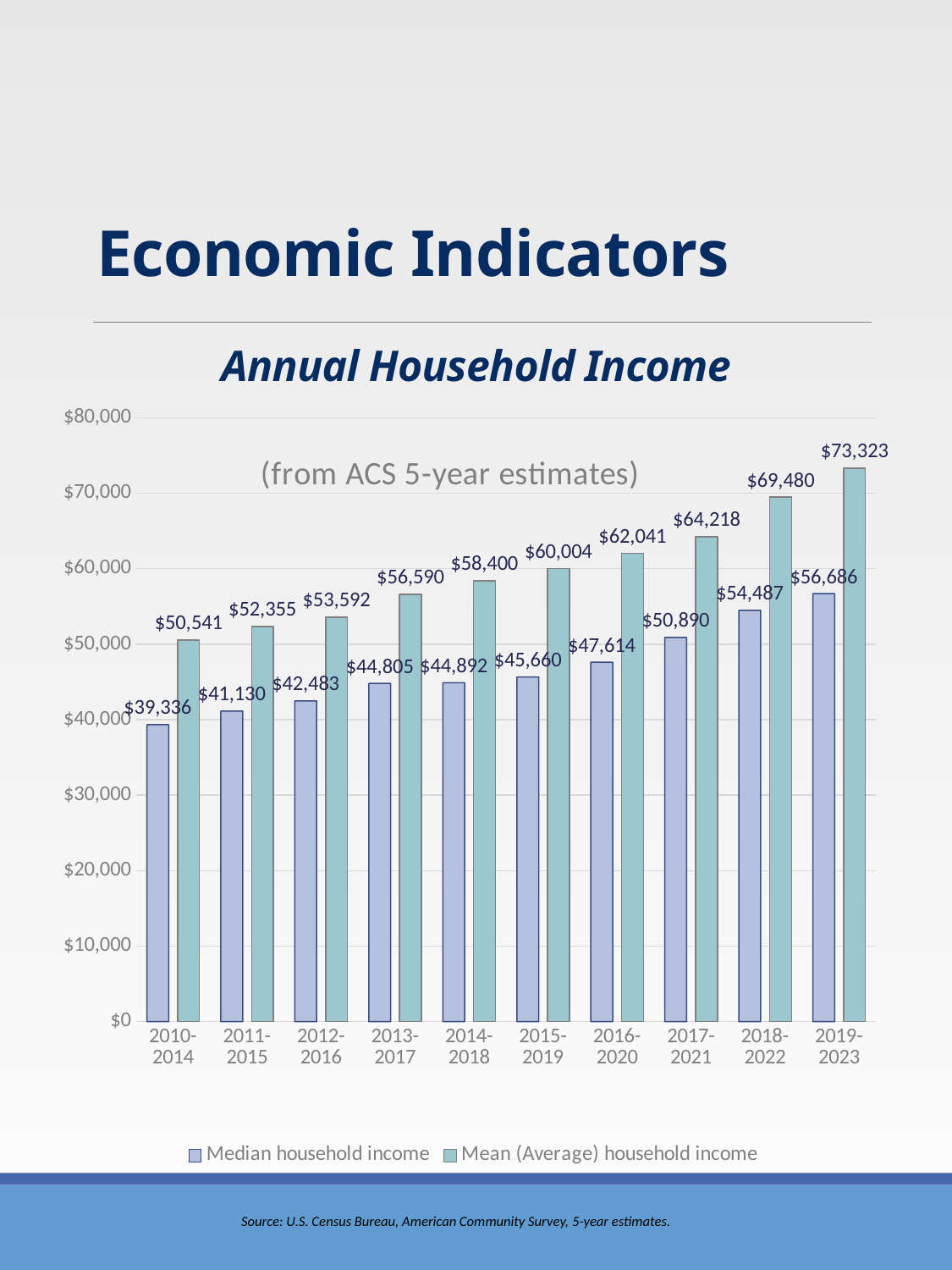
What is the median household income for 2019-2023? $56,686 Does the mean (average) household income rise or fall across the periods from 2010-2014 to 2019-2023? Rise Which period has the highest mean (average) household income? 2019-2023 What kind of chart is shown? Bar chart What is the mean (average) household income for 2010-2014? $50,541 What is the difference between the median household income for 2018-2022 and 2017-2021? $3,597 How many periods are shown on the x axis? 10 Which is larger, the mean household income for 2013-2017 or the median household income for 2019-2023? Median household income for 2019-2023 How many series does the legend list? 2 Which period has the lowest median household income? 2010-2014 What is the difference between the mean and median household income for 2019-2023? $16,637 What is the median household income for 2015-2019? $45,660